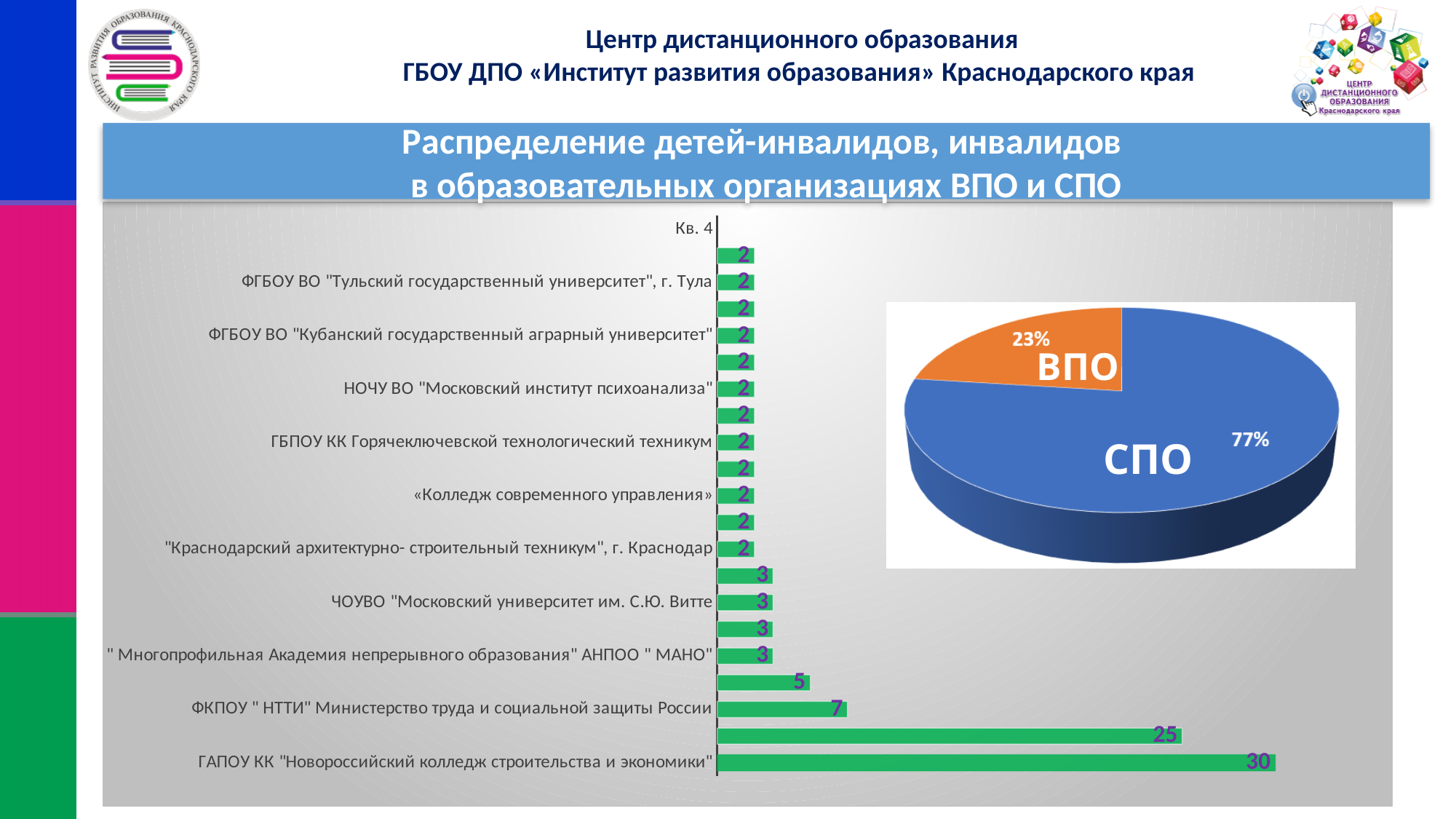
In the pie chart, which segment is larger, СПО or ВПО? СПО In the pie chart, what share does ВПО have? 23% In the bar chart, what is the value for ФГБОУ ВО "Тульский государственный университет", г. Тула? 2 In the bar chart, what is the value for ЧОУВО "Московский университет им. С.Ю. Витте"? 3 How many bars are plotted in the bar chart? 20 In the bar chart, what is the value for ФКПОУ "НТТИ" Министерство труда и социальной защиты России? 7 In the bar chart, which is larger: the value for "Многопрофильная Академия непрерывного образования" АНПОО "МАНО" or for ГБПОУ КК Горячеключевской технологический техникум? "Многопрофильная Академия непрерывного образования" АНПОО "МАНО" In the bar chart, which organization has the highest value? ГАПОУ КК "Новороссийский колледж строительства и экономики" In the pie chart, what share does СПО have? 77% In the bar chart, what is the difference between the values for ГАПОУ КК "Новороссийский колледж строительства и экономики" and ФКПОУ "НТТИ" Министерство труда и социальной защиты России? 23 In the bar chart, what is the value for ГАПОУ КК "Новороссийский колледж строительства и экономики"? 30 What type of chart is shown on the left side of the slide? Bar chart